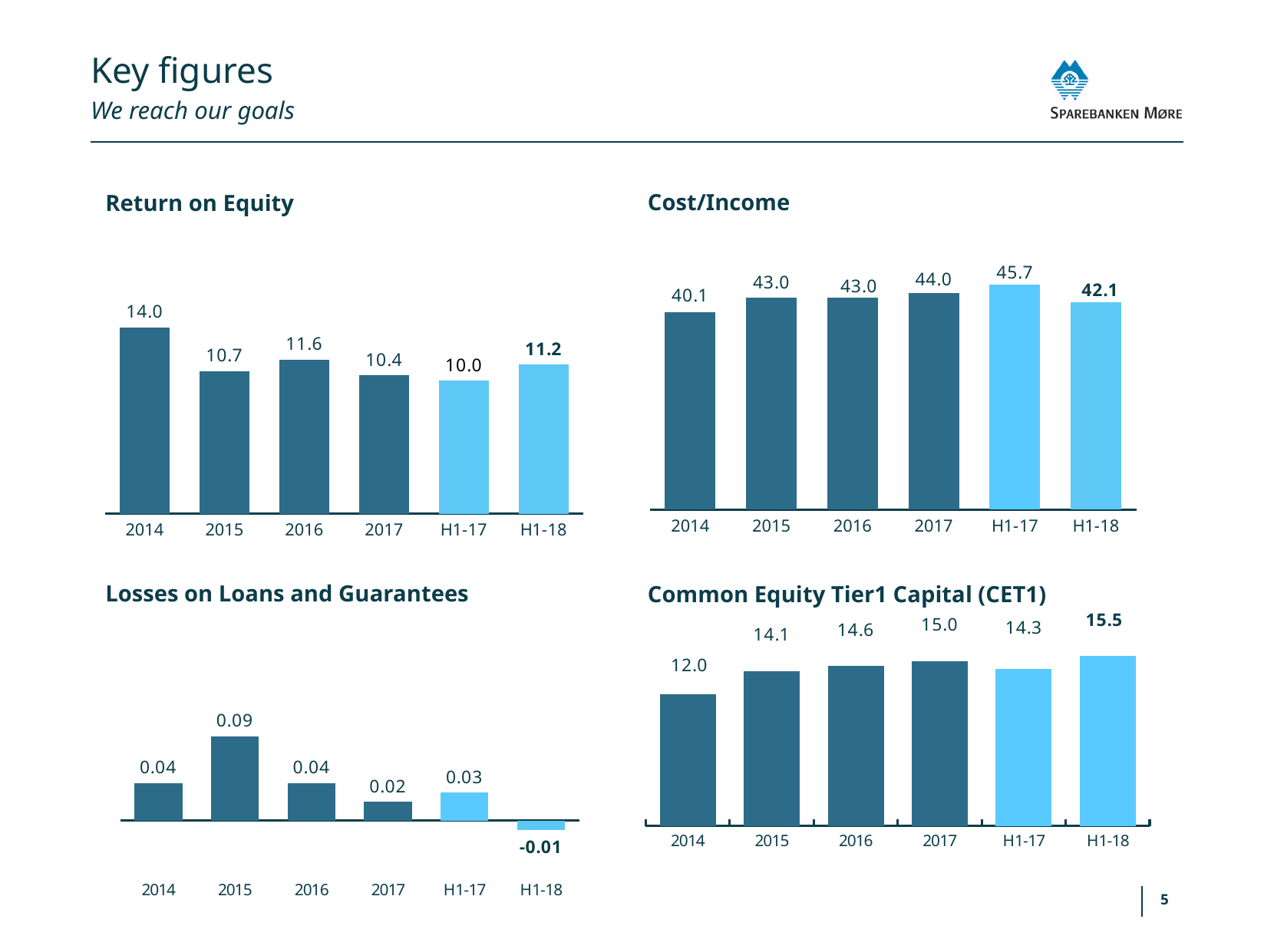
How many bars are in the Return on Equity chart? 6 In the Common Equity Tier1 Capital (CET1) chart, which period has the highest value? H1-18 In the Losses on Loans and Guarantees chart, what is the value for 2015? 0.09 In the Return on Equity chart, which period has the lowest value? H1-17 In the Losses on Loans and Guarantees chart, what is the value for H1-18? -0.01 In the Cost/Income chart, what is the difference between the H1-17 and H1-18 values? 3.6 In the Common Equity Tier1 Capital (CET1) chart, what is the difference between the 2014 and 2017 values? 3.0 In the Return on Equity chart, what is the value for 2014? 14.0 In the Cost/Income chart, which period has the highest value? H1-17 In the Common Equity Tier1 Capital (CET1) chart, is the value for 2017 or H1-17 larger? 2017 What kind of chart is the Cost/Income chart? Bar chart In the Cost/Income chart, what is the value for H1-18? 42.1